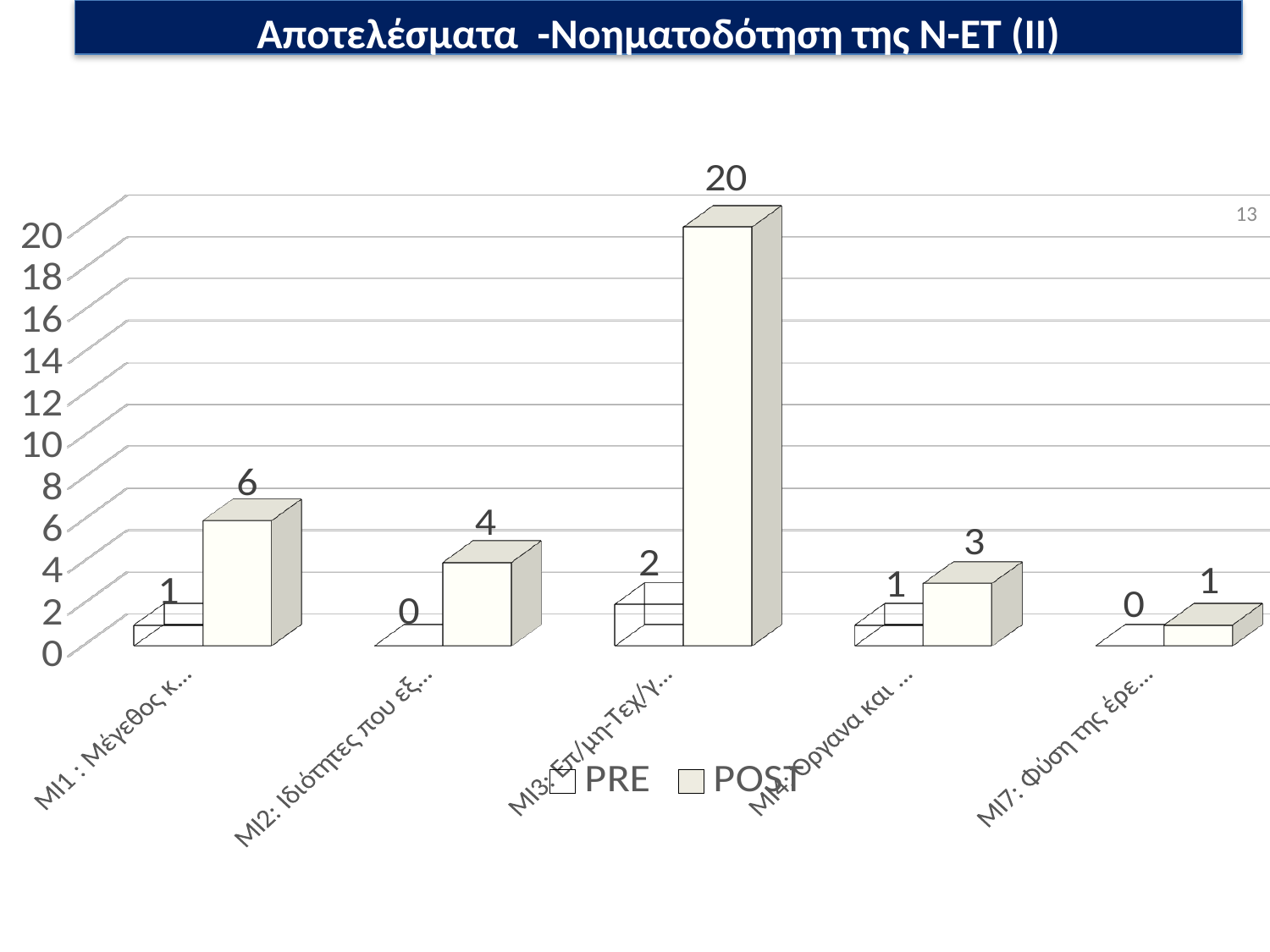
What is the POST value for the MI3 category? 20 What is the difference between the POST values for MI1 and MI4? 3 What is the PRE value for the MI1 category? 1 What kind of chart is shown on the slide? Bar chart Which category has the highest POST value? MI3 How many categories are shown on the x axis? 5 What is the PRE value for the MI7 category? 0 Which category has the lowest POST value? MI7 Which is larger, the POST value for MI1 or the POST value for MI2? POST value for MI1 How many series does the legend list? 2 What is the POST value for the MI2 category? 4 What is the difference between the POST and PRE values for the MI3 category? 18